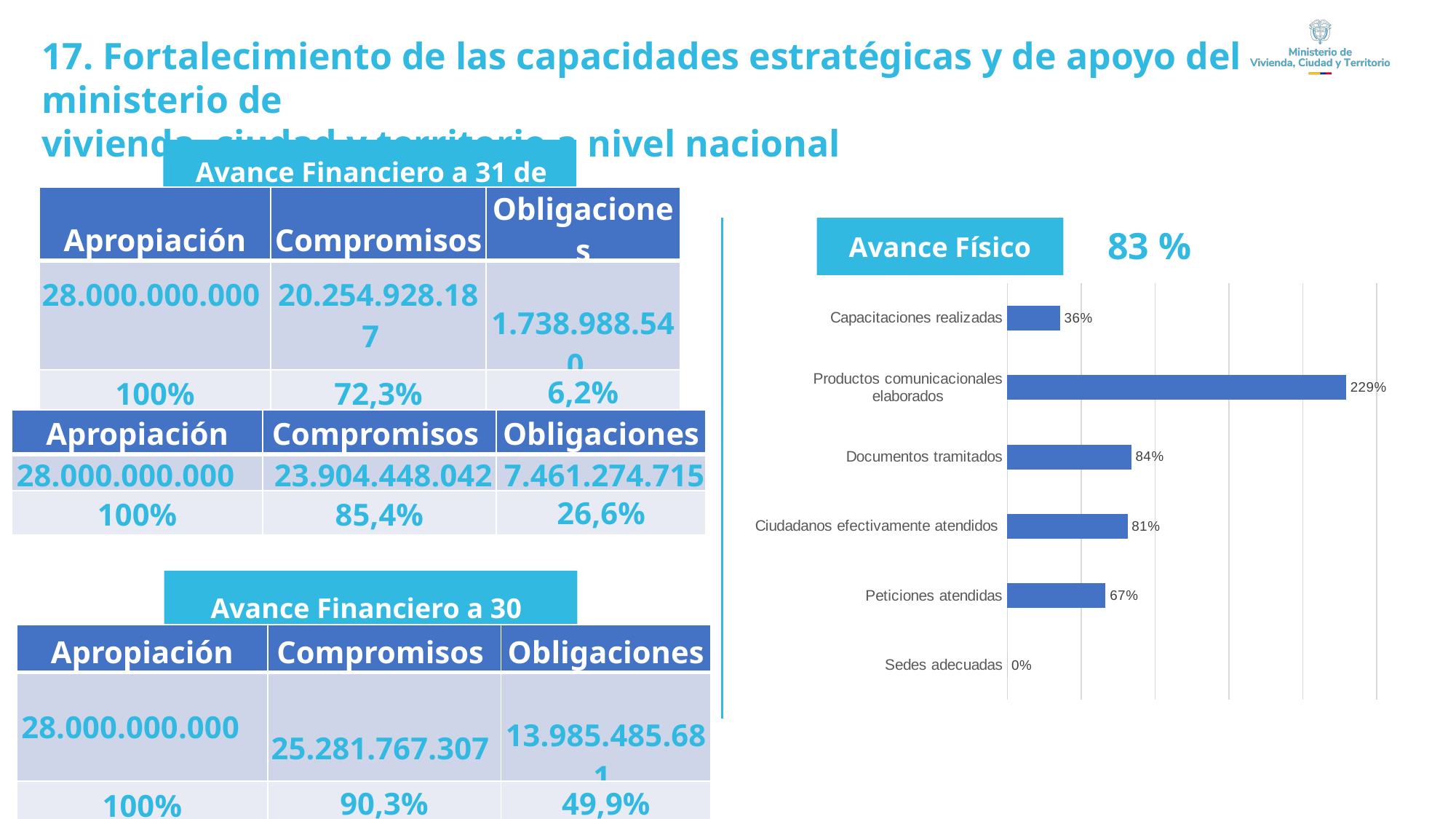
Which category has the highest value in the bar chart? Productos comunicacionales elaborados What is the value for Sedes adecuadas in the bar chart? 0% How many categories are plotted in the bar chart? 6 Which category has the lowest value in the bar chart? Sedes adecuadas In the bar chart, which is larger: Documentos tramitados or Ciudadanos efectivamente atendidos? Documentos tramitados What is the value for Capacitaciones realizadas in the bar chart? 36% In the bar chart, what is the difference between Productos comunicacionales elaborados and Capacitaciones realizadas? 193 percentage points What is the value for Peticiones atendidas in the bar chart? 67% What is the value for Productos comunicacionales elaborados in the bar chart? 229% What overall percentage is shown next to the 'Avance Físico' label above the bar chart? 83 % What type of chart is shown on the right side of the slide? bar chart In the bar chart, what is the difference between Documentos tramitados and Ciudadanos efectivamente atendidos? 3 percentage points